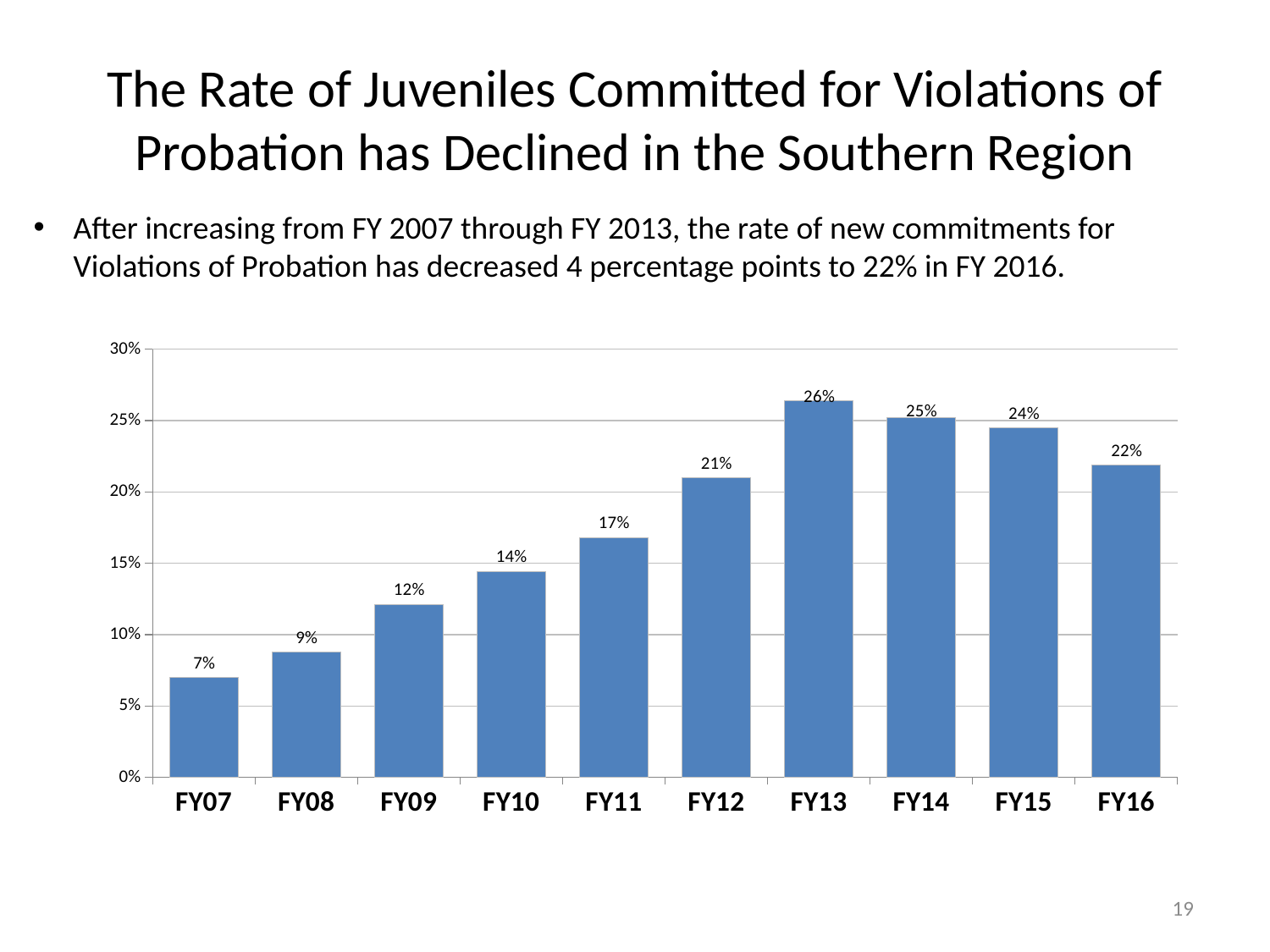
What is the value for FY10? 14% What is the value for FY16? 22% Which is larger, the value for FY12 or the value for FY15? FY15 Which fiscal year has the highest value? FY13 What kind of chart is shown on the slide? Bar chart What is the difference between the values for FY13 and FY16? 4% Which fiscal year has the lowest value? FY07 What is the difference between the values for FY11 and FY08? 8% What is the value for FY13? 26% What is the value for FY07? 7% Do the values rise or fall from FY07 to FY13? Rise How many fiscal years are shown on the x axis? 10